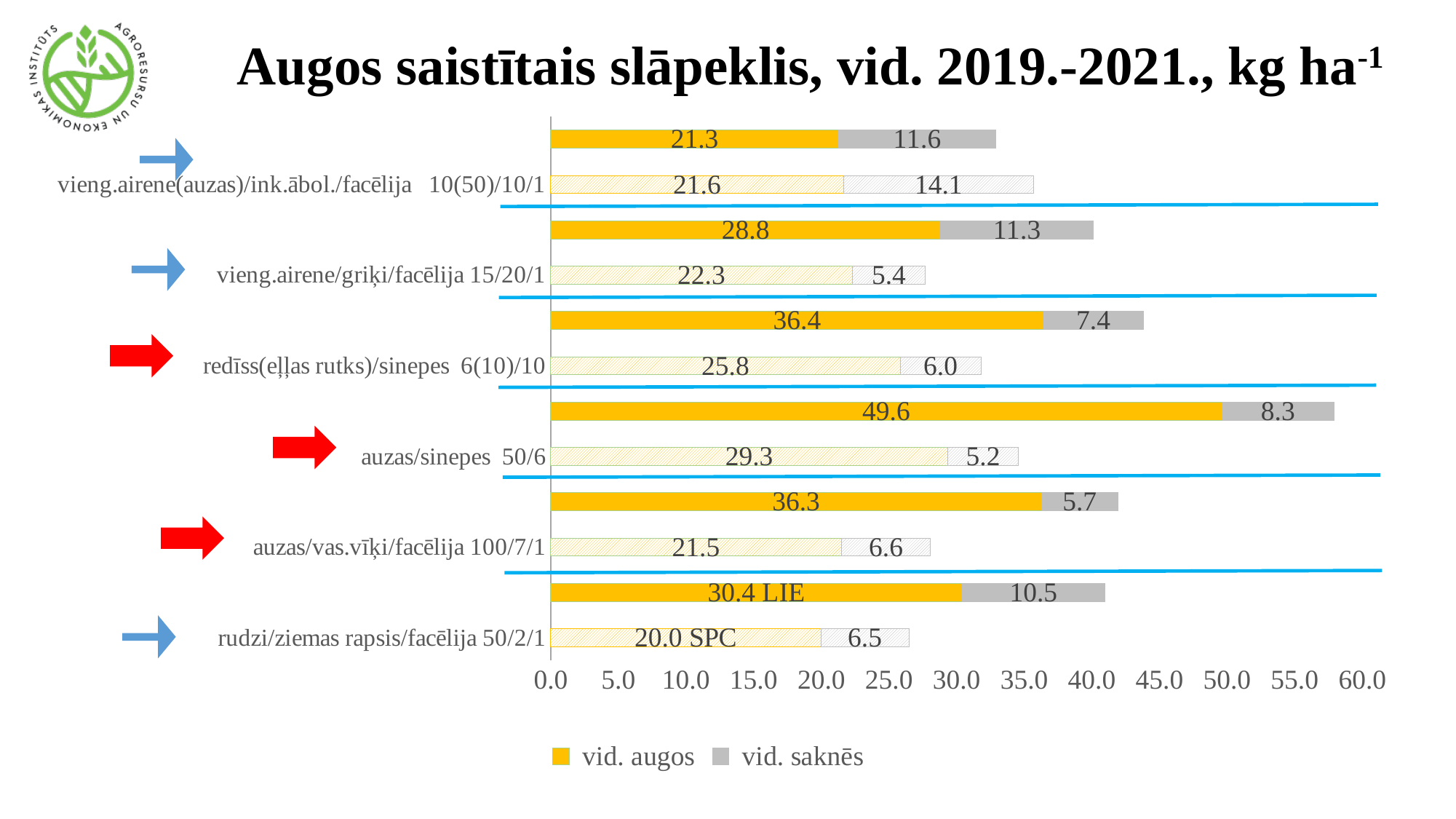
How many crop mixture categories are shown on the y axis? 6 How many series does the legend list? 2 What is the total of the solid (LIE) stacked bar for auzas/sinepes 50/6? 57.9 What type of chart is shown on the slide? stacked bar chart Which category has the lowest 'vid. augos' value among the hatched (SPC) bars? rudzi/ziemas rapsis/facēlija 50/2/1 What is the 'vid. saknēs' value for the hatched (SPC) bar of vieng.airene(auzas)/ink.ābol./facēlija 10(50)/10/1? 14.1 Which category has the highest 'vid. augos' value among the solid (LIE) bars? auzas/sinepes 50/6 Which is larger: the 'vid. saknēs' value of the solid (LIE) bar for vieng.airene/griķi/facēlija 15/20/1 or for redīss(eļļas rutks)/sinepes 6(10)/10? vieng.airene/griķi/facēlija 15/20/1 What is the 'vid. augos' value for the hatched (SPC) bar of rudzi/ziemas rapsis/facēlija 50/2/1? 20.0 Which series is shown in yellow in the legend? vid. augos What is the difference between the 'vid. augos' values of the solid (LIE) bar and the hatched (SPC) bar for auzas/sinepes 50/6? 20.3 What is the 'vid. augos' value for the solid (LIE) bar of auzas/sinepes 50/6? 49.6